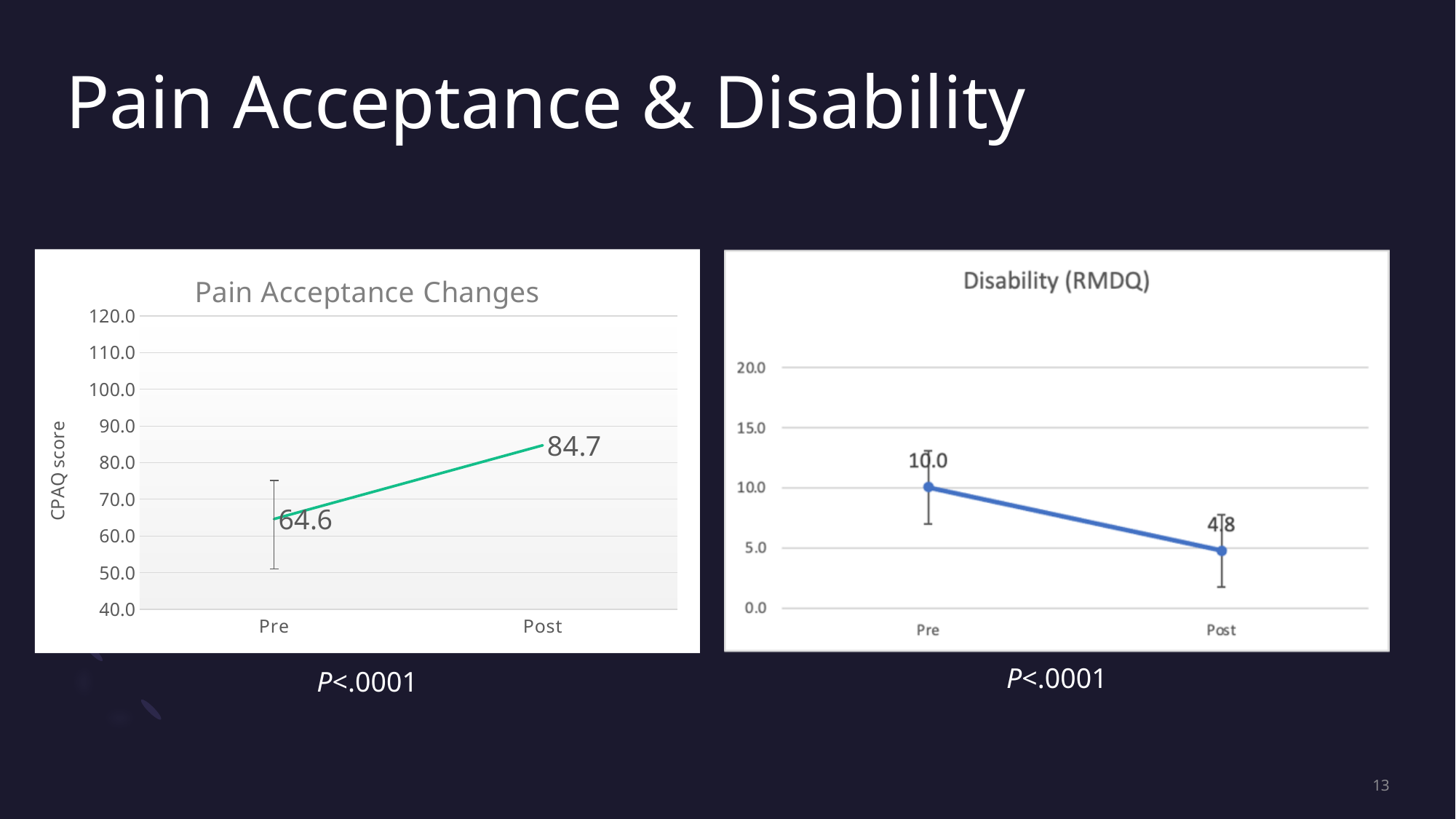
In the Disability (RMDQ) chart, does the value rise or fall from Pre to Post? fall In the Pain Acceptance Changes chart, what is the CPAQ score at Pre? 64.6 In the Pain Acceptance Changes chart, what is the y-axis label? CPAQ score In the Disability (RMDQ) chart, what is the difference between the Pre and Post values? 5.2 In the Pain Acceptance Changes chart, does the CPAQ score rise or fall from Pre to Post? rise In the Pain Acceptance Changes chart, what is the CPAQ score at Post? 84.7 How many time points are plotted in the Disability (RMDQ) chart? 2 What kind of chart is the Pain Acceptance Changes chart? line chart In the Pain Acceptance Changes chart, by how much does the CPAQ score increase from Pre to Post? 20.1 In the Pain Acceptance Changes chart, which time point has the higher CPAQ score? Post In the Disability (RMDQ) chart, what is the value at Pre? 10.0 In the Disability (RMDQ) chart, what is the value at Post? 4.8